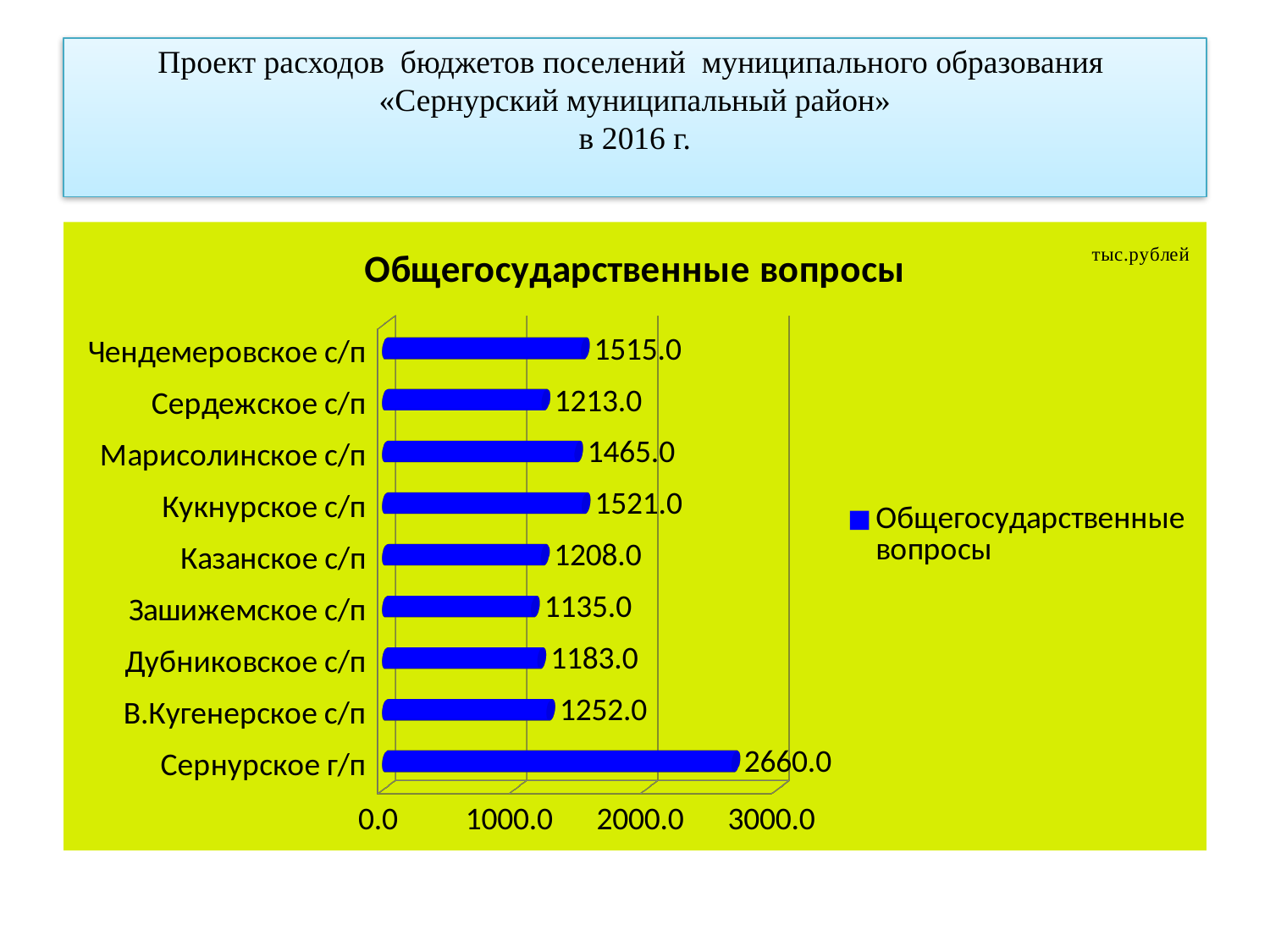
Which is larger, the value for Сердежское с/п or the value for Казанское с/п? Сердежское с/п Which category has the highest value? Сернурское г/п Is the value for Дубниковское с/п greater or less than 1000.0? greater What is the difference between the values for Кукнурское с/п and Чендемеровское с/п? 6.0 How many series does the legend list? 1 What is the value for Марисолинское с/п? 1465.0 What is the difference between the values for Сернурское г/п and В.Кугенерское с/п? 1408.0 What kind of chart is shown? bar chart What is the value for Зашижемское с/п? 1135.0 What is the value for Сернурское г/п? 2660.0 Which category has the lowest value? Зашижемское с/п How many categories are shown in the chart? 9